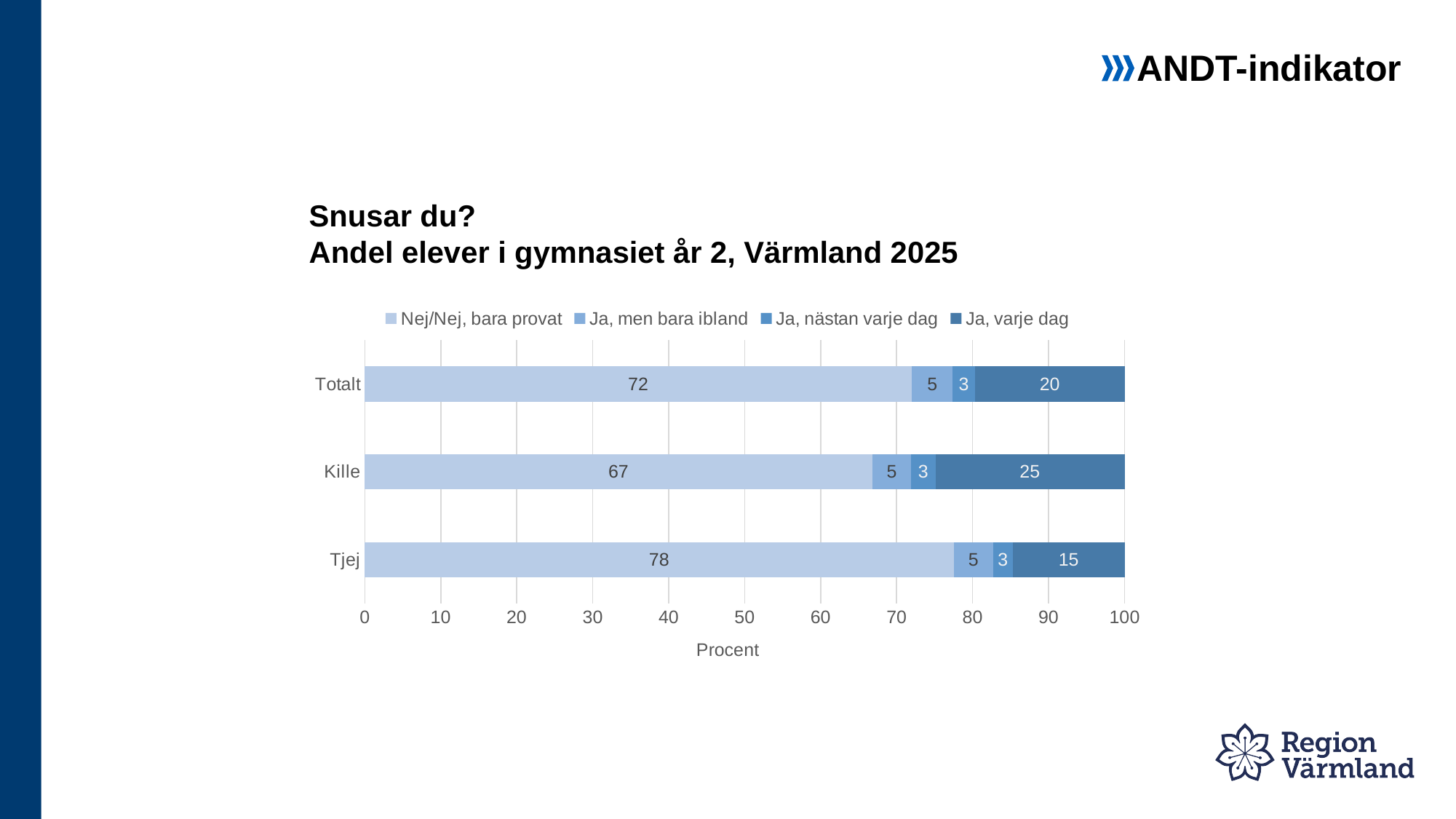
How many categories are shown on the y axis? 3 What is the value for "Ja, varje dag" for Kille? 25 Which is larger: the "Nej/Nej, bara provat" value for Kille or for Totalt? Totalt What is the difference between the "Ja, varje dag" values for Kille and Tjej? 10 What is the value for "Ja, men bara ibland" for Kille? 5 What kind of chart is shown? Stacked bar chart What is the value for "Nej/Nej, bara provat" for Totalt? 72 Which category has the highest value for "Nej/Nej, bara provat"? Tjej Which category has the lowest value for "Ja, varje dag"? Tjej What is the value for "Ja, varje dag" for Tjej? 15 How many series does the legend list? 4 What is the label of the x axis? Procent